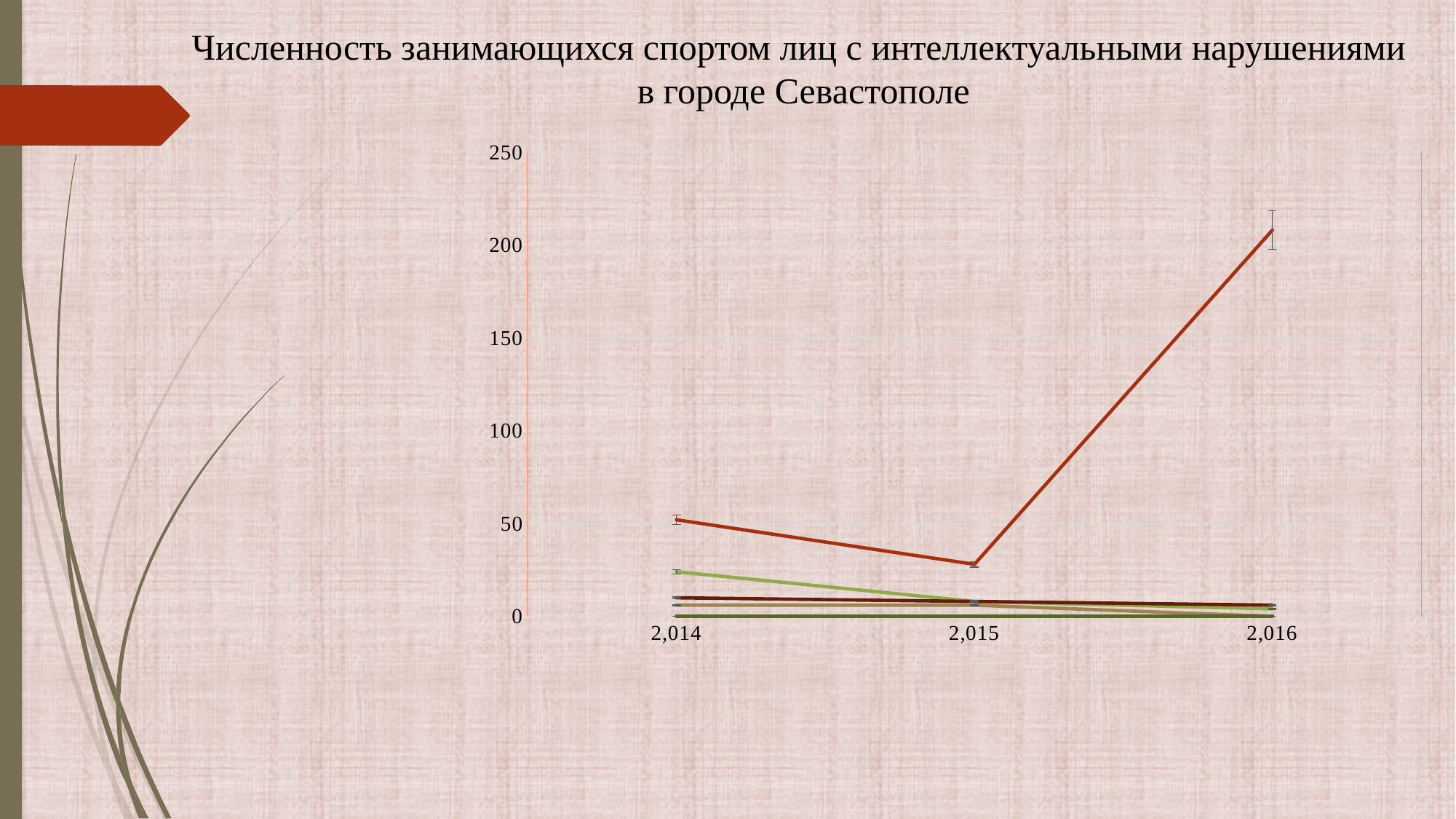
What kind of chart is shown on the slide? line chart What is the highest value shown on the y axis of the chart? 250 Does the red line rise or fall between 2,015 and 2,016? rise How many years are shown on the x axis of the chart? 3 What is the title of the chart on the slide? Численность занимающихся спортом лиц с интеллектуальными нарушениями в городе Севастополе In which year does the red line reach its lowest value? 2,015 Which is larger for the red line: the value at 2,014 or the value at 2,016? 2,016 In which year does the red line reach its highest value? 2,016 Is the value of the red line at 2,015 greater or less than 50? less Does the red line rise or fall between 2,014 and 2,015? fall Is the value of the red line at 2,016 greater or less than 200? greater Is the value of the red line at 2,014 greater or less than 100? less